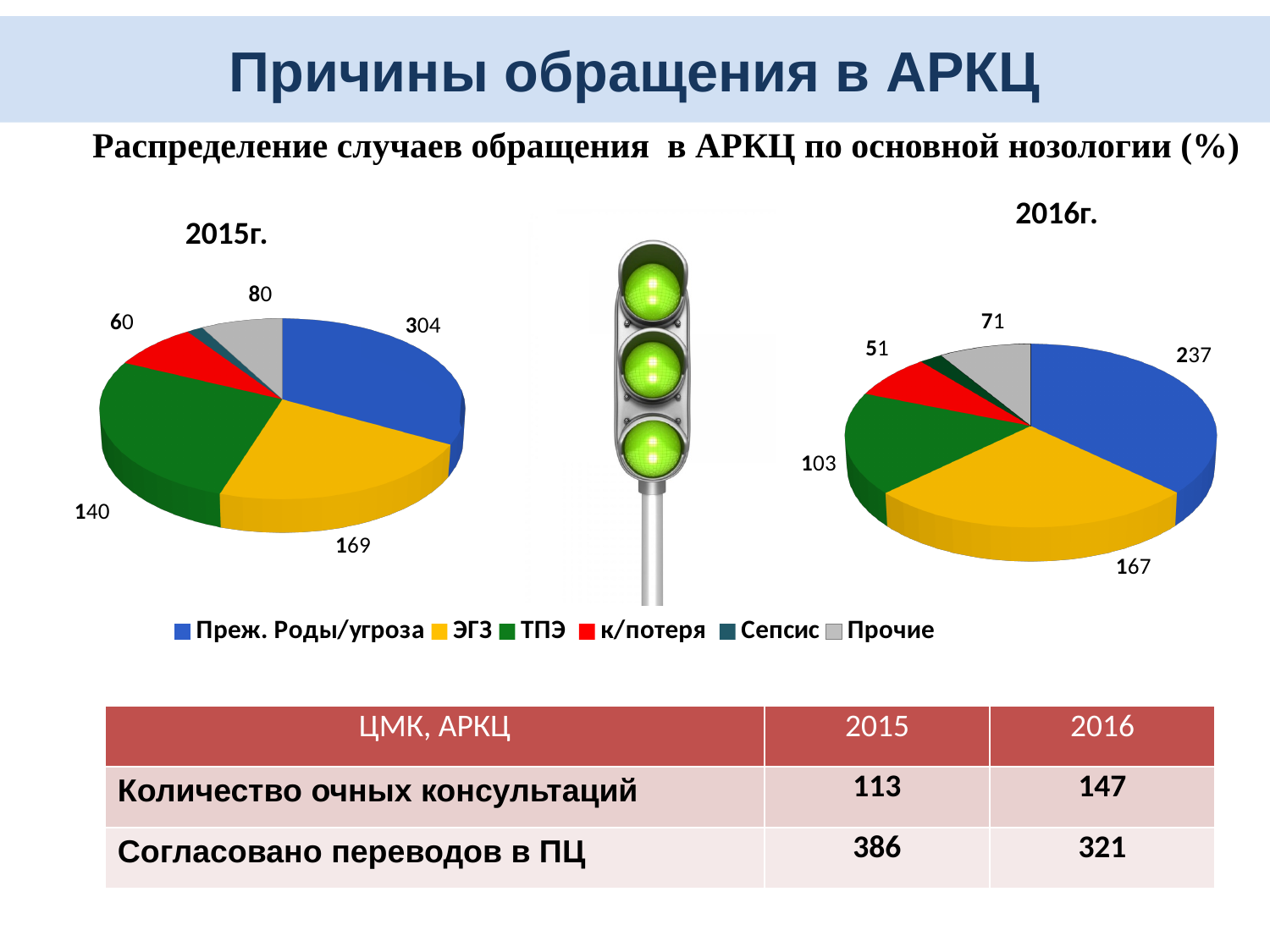
In the 2016г. pie chart, what is the value for ЭГЗ? 167 Which colour represents ЭГЗ in the pie charts? Yellow In the 2016г. pie chart, what is the value for к/потеря? 51 What type of chart is used for the 2015г. and 2016г. data? Pie chart In the 2015г. pie chart, what is the value for ТПЭ? 140 In the 2016г. pie chart, what is the value for Прочие? 71 In the 2016г. pie chart, which category has the smallest slice? Сепсис How many categories does the legend list for the pie charts? 6 In the 2015г. pie chart, what is the value for Преж. Роды/угроза? 304 In the 2015г. pie chart, which category has the largest slice? Преж. Роды/угроза What is the difference between the Преж. Роды/угроза value in the 2015г. chart and in the 2016г. chart? 67